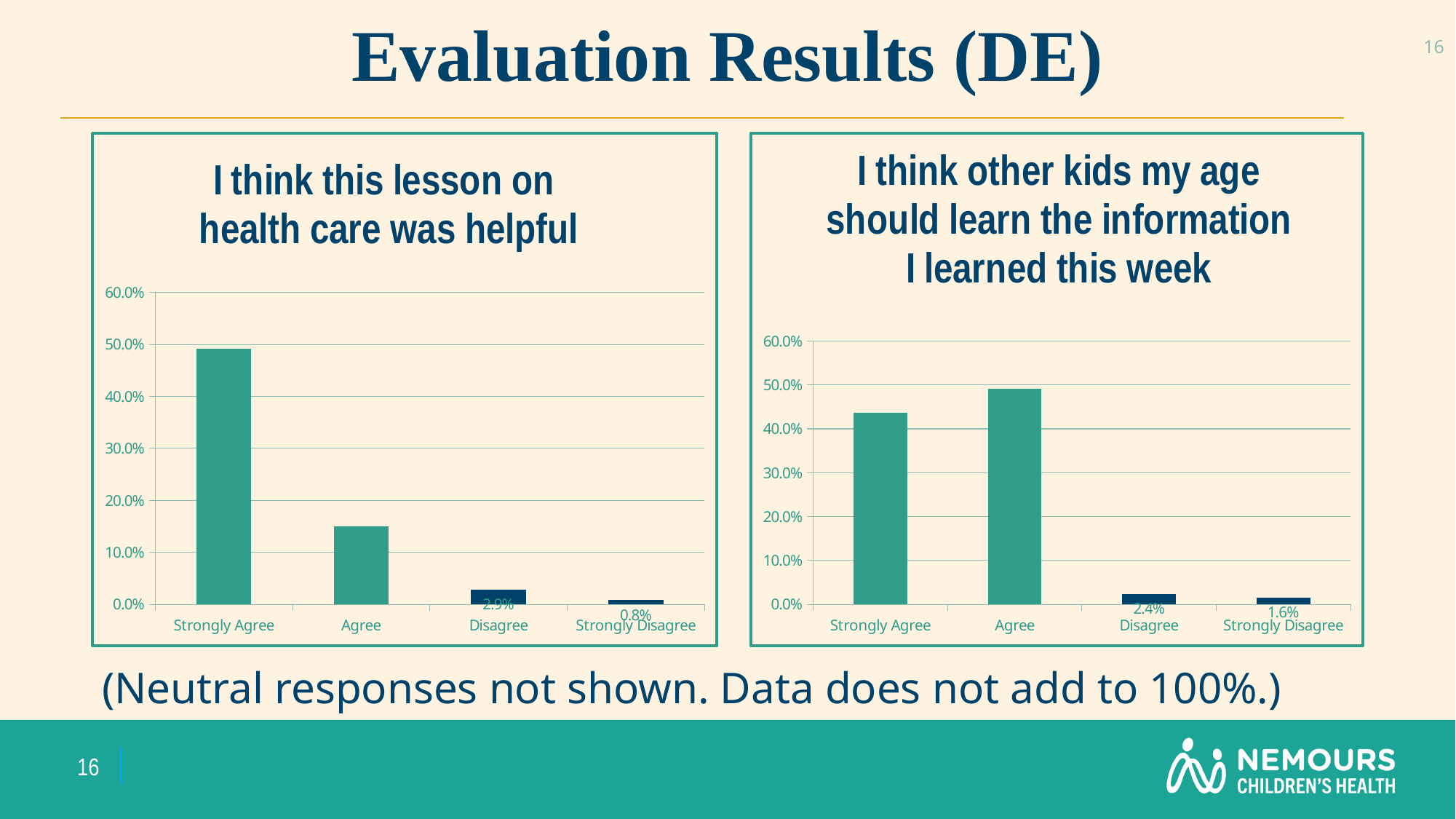
How many categories are shown on the x axis of the right chart? 4 In the left chart, which category has the lowest value? Strongly Disagree What type of chart is the left chart? Bar chart In the right chart, what is the difference between the values for Disagree and Strongly Disagree? 0.8% In the left chart, is the value for Strongly Agree greater or less than 40.0%? greater In the chart titled "I think this lesson on health care was helpful", what is the value for Disagree? 2.9% In the right chart, which category has the highest value? Agree In the left chart, which category has the highest value? Strongly Agree In the left chart, is the value for Agree greater or less than 20.0%? less In the chart titled "I think other kids my age should learn the information I learned this week", what is the value for Disagree? 2.4% In the chart titled "I think this lesson on health care was helpful", what is the value for Strongly Disagree? 0.8% In the chart titled "I think other kids my age should learn the information I learned this week", what is the value for Strongly Disagree? 1.6%